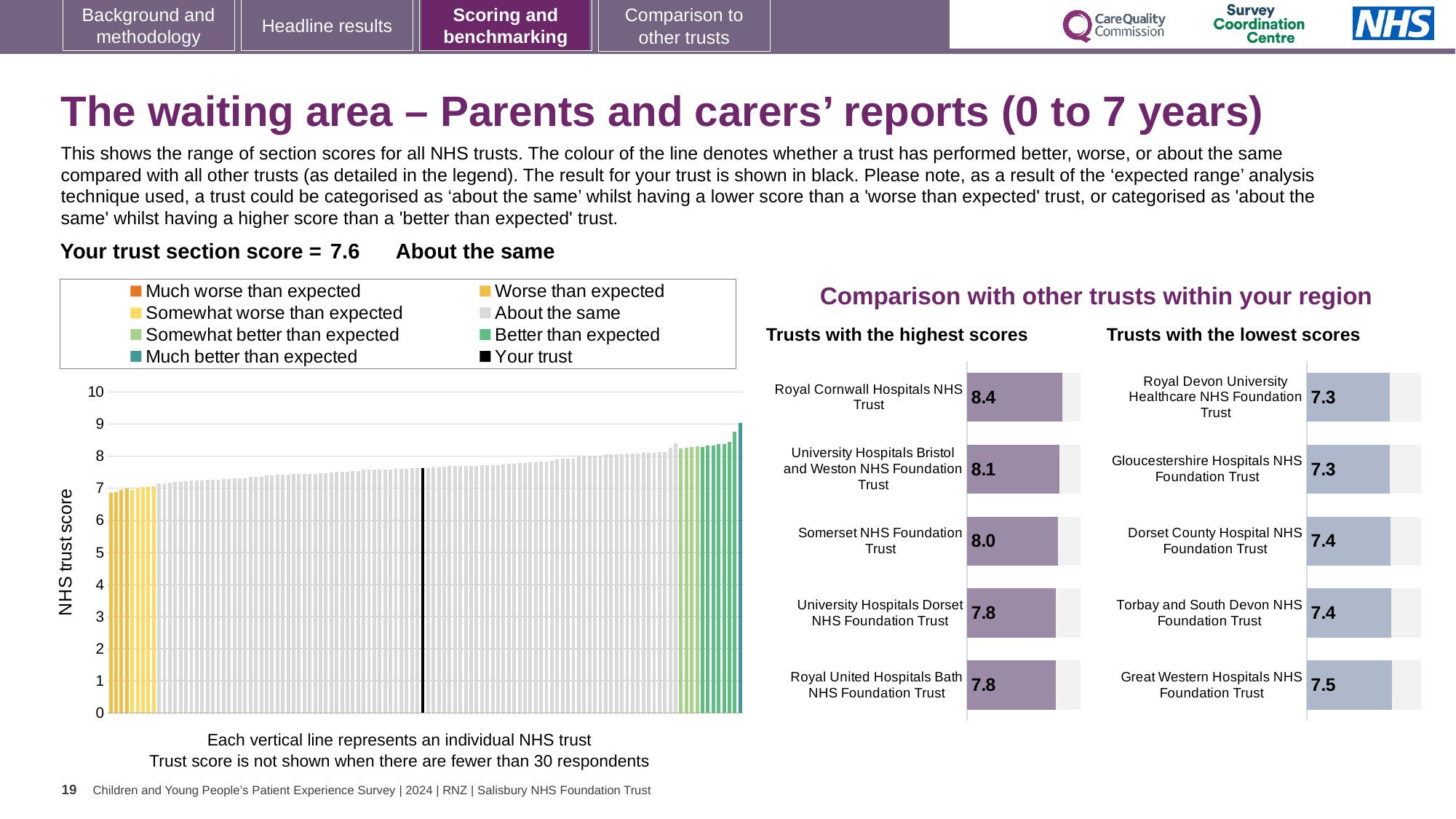
In the 'Trusts with the highest scores' chart, what is the difference between the scores of Royal Cornwall Hospitals NHS Trust and Somerset NHS Foundation Trust? 0.4 In the 'Trusts with the lowest scores' chart, what is the score for Great Western Hospitals NHS Foundation Trust? 7.5 How many entries does the legend above the large chart on the left list? 8 In the 'Trusts with the lowest scores' chart, what is the score for Dorset County Hospital NHS Foundation Trust? 7.4 In the 'Trusts with the highest scores' chart, which trust has the highest score? Royal Cornwall Hospitals NHS Trust What kind of chart is the large chart on the left showing NHS trust scores? Bar chart In the 'Trusts with the highest scores' chart, what is the score for Royal Cornwall Hospitals NHS Trust? 8.4 In the large chart on the left, do the trust scores rise or fall from left to right? Rise In the 'Trusts with the highest scores' chart, which has the larger score: University Hospitals Bristol and Weston NHS Foundation Trust or Somerset NHS Foundation Trust? University Hospitals Bristol and Weston NHS Foundation Trust In the 'Trusts with the lowest scores' chart, which trust has the highest score? Great Western Hospitals NHS Foundation Trust How many trusts are listed in the 'Trusts with the highest scores' chart? 5 What is the section score for your trust shown on the slide? 7.6